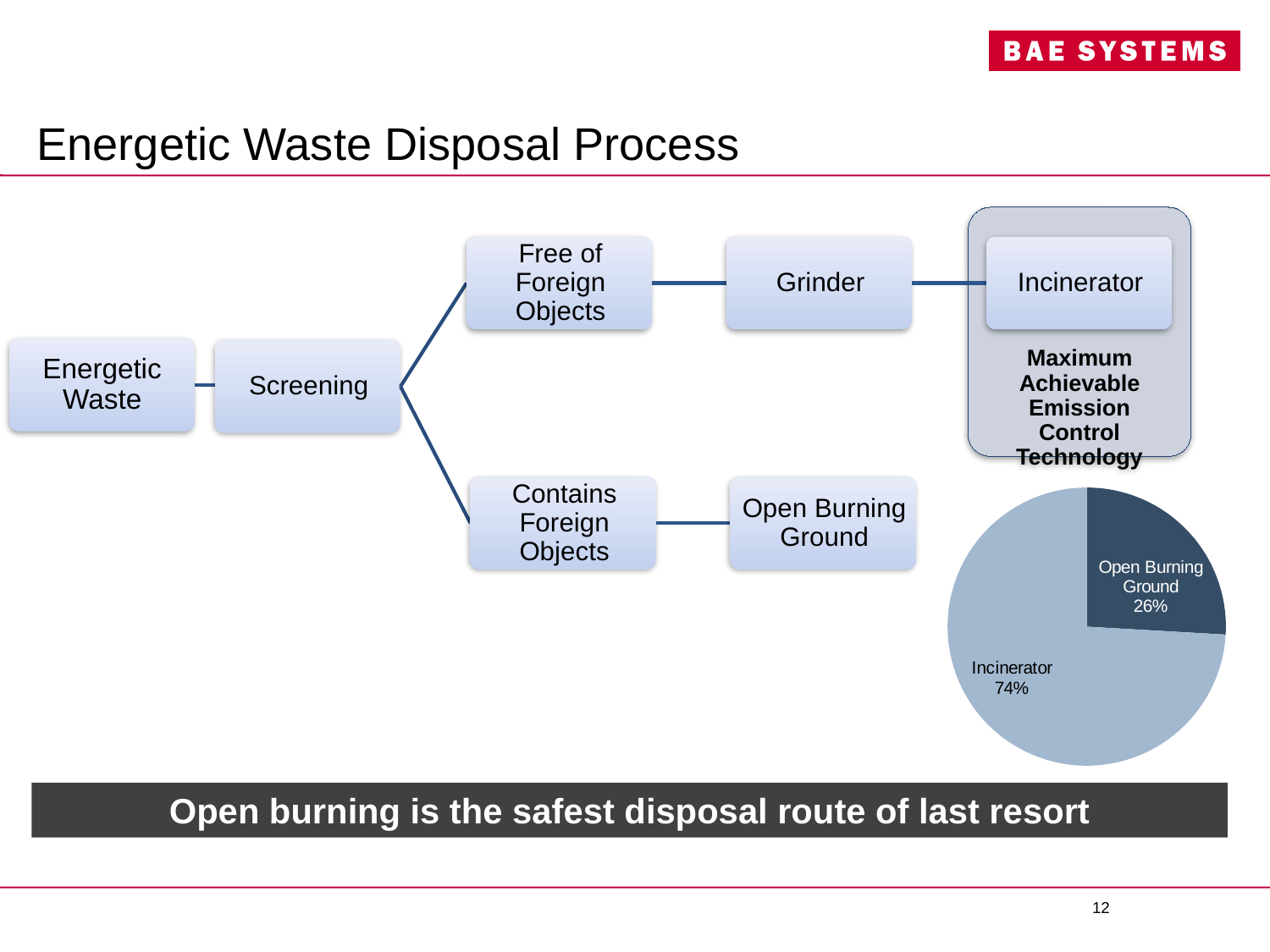
What is the difference in percentage points between the Incinerator and Open Burning Ground slices? 48 What share of the pie chart is labelled Incinerator? 74% Is the Open Burning Ground share greater or less than 50%? less Which is larger in the pie chart, Incinerator or Open Burning Ground? Incinerator Is the Incinerator share greater or less than 50%? greater Which slice of the pie chart is the largest? Incinerator What kind of chart is shown on the slide? pie chart What share of the pie chart is labelled Open Burning Ground? 26% How many slices does the pie chart have? 2 Which slice of the pie chart is drawn in the darker colour? Open Burning Ground Which slice of the pie chart is the smallest? Open Burning Ground What is the total of the two slices in the pie chart? 100%